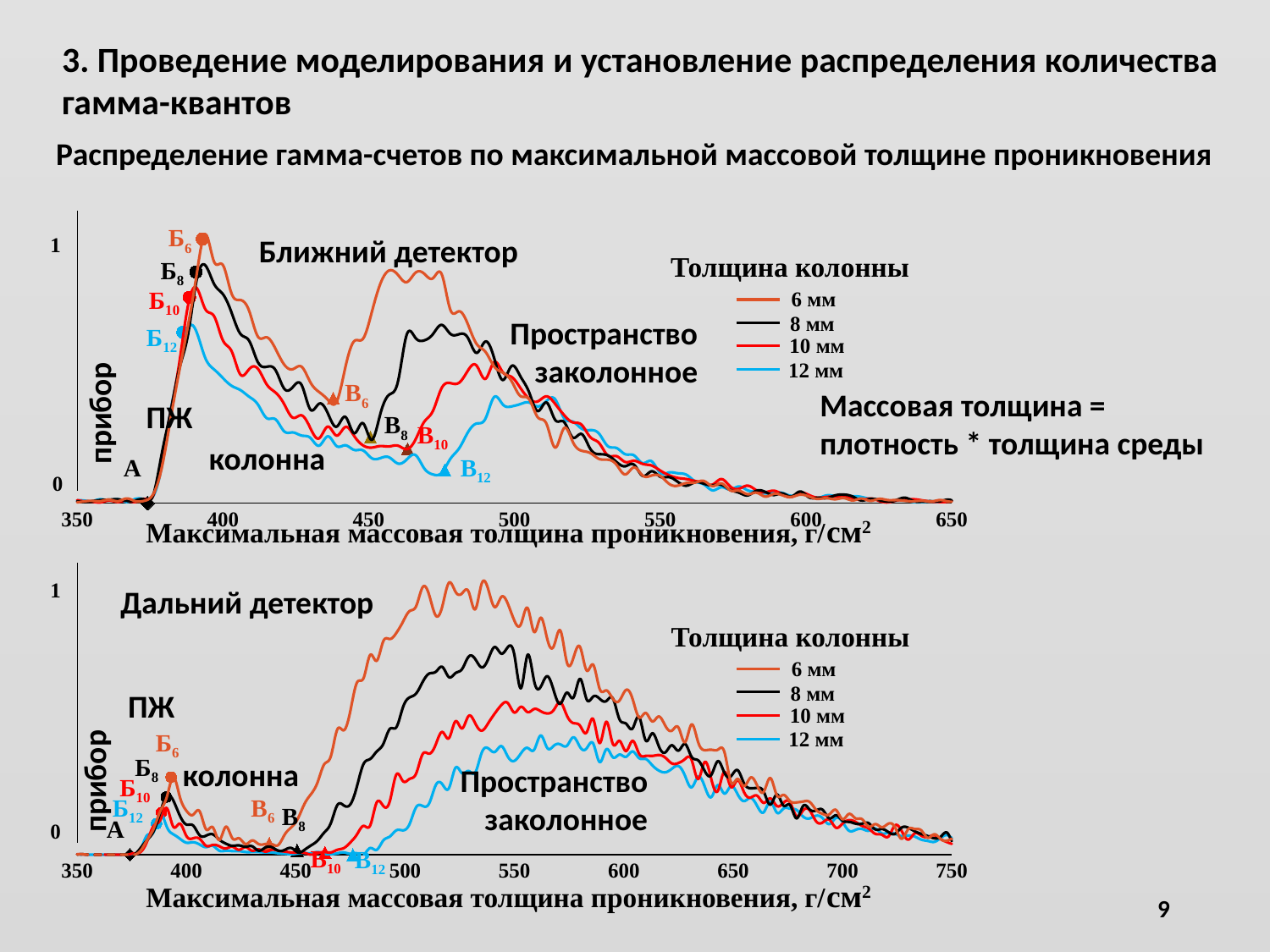
In the bottom chart ("Дальний детектор"), which series has the lowest values around 550 г/см²? 12 мм In the bottom chart ("Дальний детектор"), around 550 г/см², is the 8 мм series higher or lower than the 10 мм series? higher In the bottom chart ("Дальний детектор"), do the values rise or fall along the x axis between 600 and 750 г/см²? fall In the bottom chart ("Дальний детектор"), what is the largest value shown on the x axis? 750 In the top chart ("Ближний детектор"), which series reaches the highest peak near 400 г/см²? 6 мм In the bottom chart ("Дальний детектор"), which series reaches the highest values around 550 г/см²? 6 мм In the top chart ("Ближний детектор"), which series has the lowest peak near 400 г/см²? 12 мм What are the legend entries of the bottom chart ("Дальний детектор")? 6 мм, 8 мм, 10 мм, 12 мм In the top chart ("Ближний детектор"), what is the largest value shown on the x axis? 650 What kind of chart is the top chart titled "Ближний детектор"? line chart What is the x-axis title of the top chart ("Ближний детектор")? Максимальная массовая толщина проникновения, г/см² How many series does the legend of the top chart ("Ближний детектор") list? 4